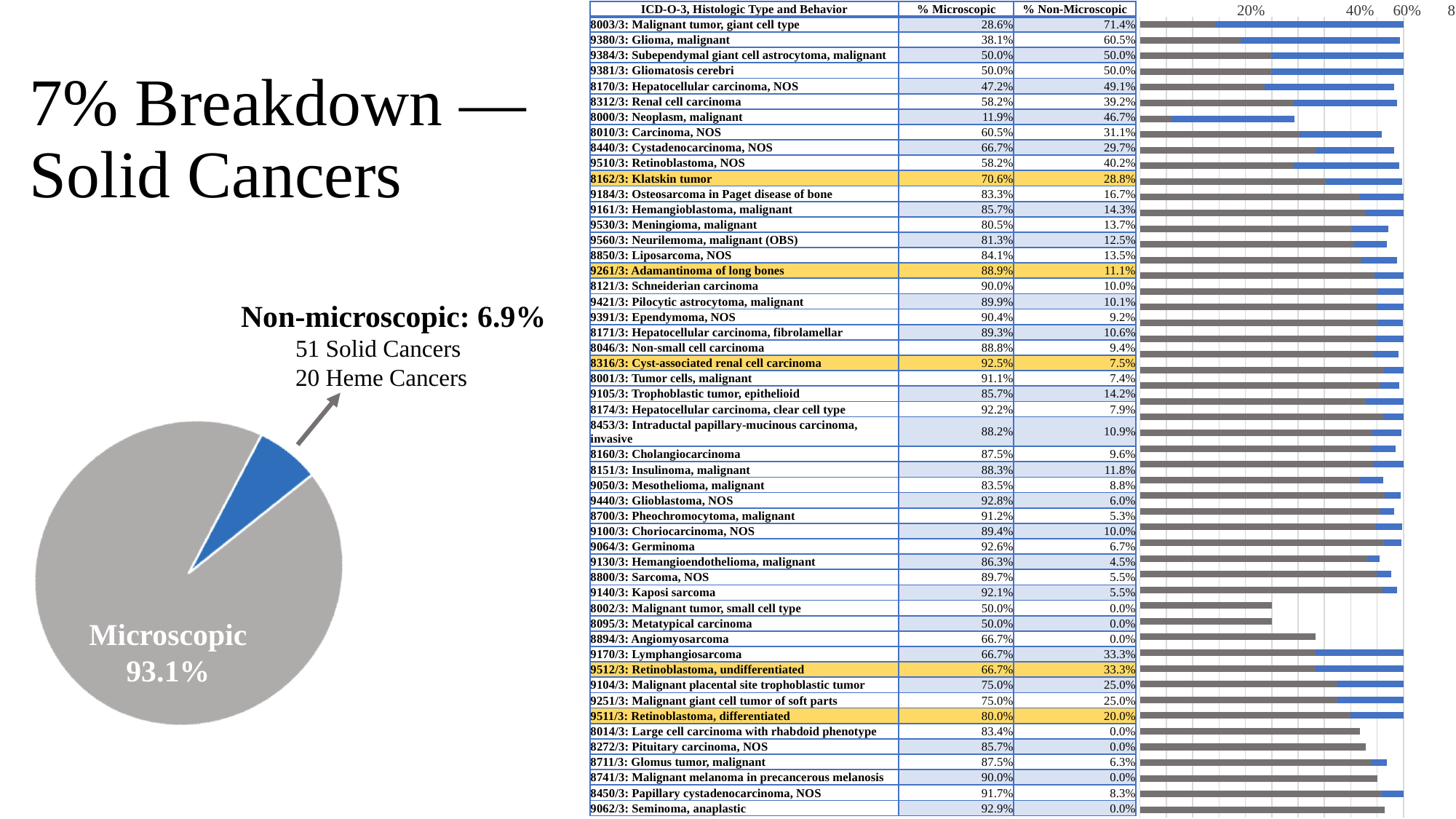
What kind of chart is shown on the right side of the slide next to the table? bar chart In the pie chart, which slice is the smallest? Non-microscopic In the pie chart, what share does the Non-microscopic slice represent? 6.9% In the pie chart, what share does the Microscopic slice represent? 93.1% How many histologic types (bars) are listed in the table beside the bar chart on the right? 51 What colour is the Non-microscopic slice in the pie chart? blue What kind of chart is shown on the left of the slide? pie chart In the pie chart, which slice is larger, Microscopic or Non-microscopic? Microscopic What is the title of the slide? 7% Breakdown — Solid Cancers In the pie chart, what is the difference in percentage points between the Microscopic and Non-microscopic shares? 86.2 percentage points How many slices does the pie chart have? 2